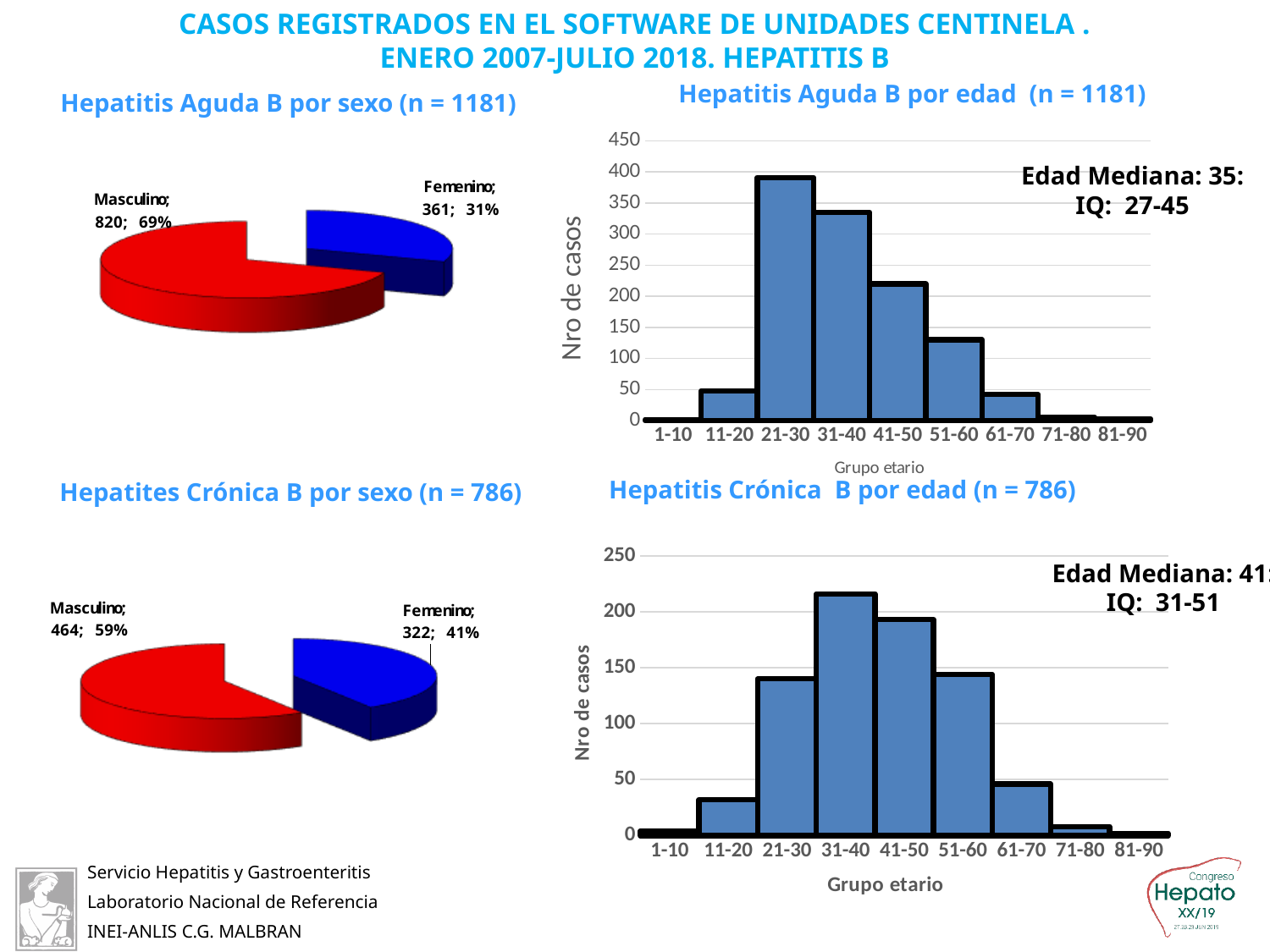
In the 'Hepatitis Crónica B por edad (n = 786)' chart, is the value for the 51-60 age group greater or less than 100? greater In the 'Hepatitis Aguda B por sexo (n = 1181)' pie chart, how many more Masculino cases are there than Femenino cases? 459 What kind of chart is 'Hepatitis Crónica B por edad (n = 786)'? bar chart In the 'Hepatites Crónica B por sexo (n = 786)' pie chart, how many cases are Femenino? 322 In the 'Hepatitis Aguda B por edad (n = 1181)' chart, which age group has the highest number of cases? 21-30 In the 'Hepatites Crónica B por sexo (n = 786)' pie chart, what share of cases is Masculino? 59% In the 'Hepatitis Aguda B por edad (n = 1181)' chart, is the value for the 21-30 age group greater or less than 350? greater In the 'Hepatitis Crónica B por edad (n = 786)' chart, which age group has the highest number of cases? 31-40 In the 'Hepatitis Aguda B por edad (n = 1181)' chart, which age group has more cases, 41-50 or 51-60? 41-50 How many age groups are shown on the x axis of the 'Hepatitis Crónica B por edad (n = 786)' chart? 9 In the 'Hepatitis Aguda B por sexo (n = 1181)' pie chart, what share of cases is Femenino? 31% In the 'Hepatitis Aguda B por sexo (n = 1181)' pie chart, how many cases are Masculino? 820